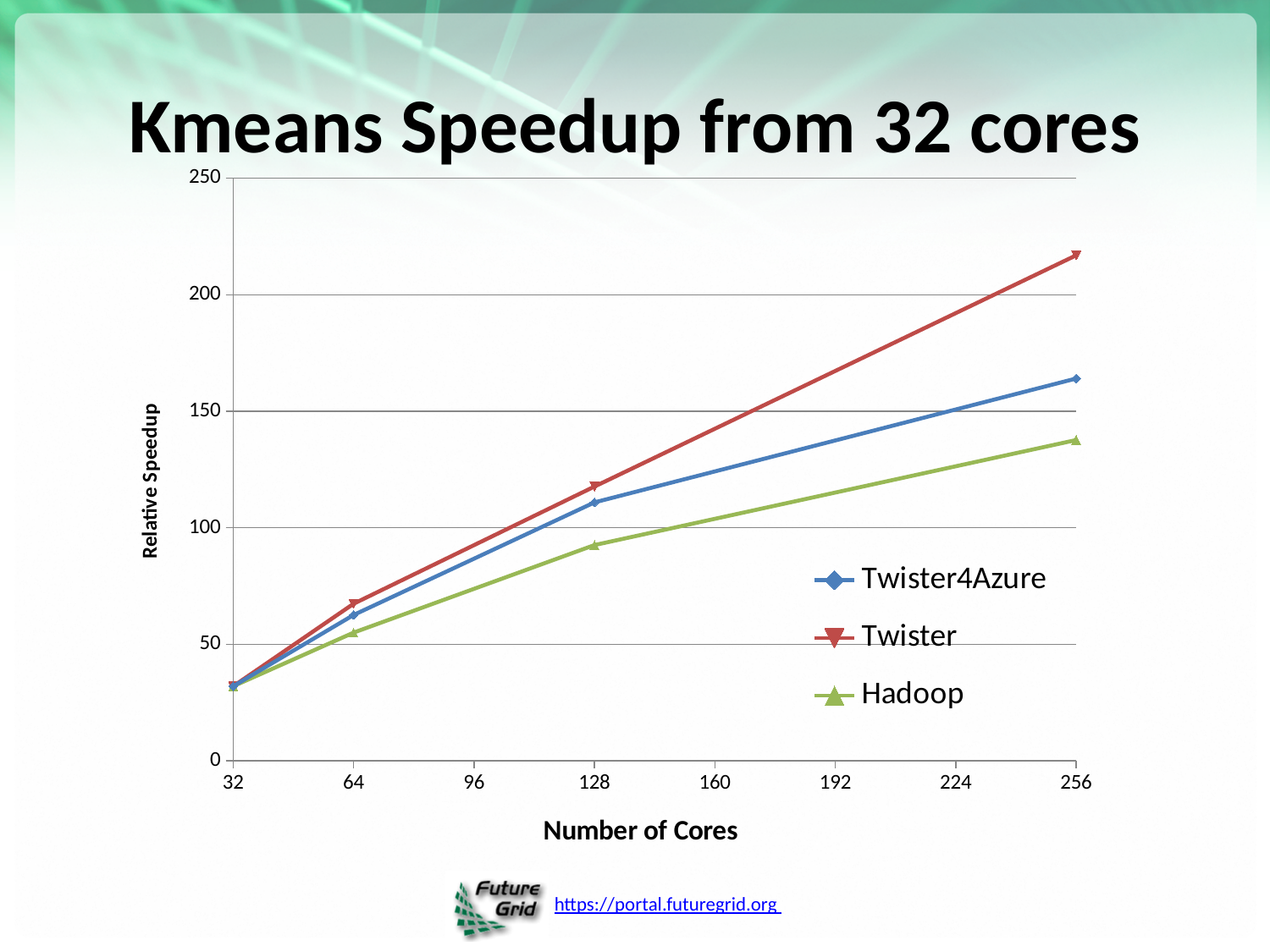
What kind of chart is shown on the slide? line chart Is the relative speedup for Twister at 128 cores greater or less than 100? greater What is the title of the chart? Kmeans Speedup from 32 cores At 256 cores, which has the larger relative speedup, Twister4Azure or Hadoop? Twister4Azure Do the relative speedup values rise or fall as the number of cores increases? rise Is the relative speedup for Twister at 256 cores greater or less than 200? greater Which series has the highest relative speedup at 256 cores? Twister Which series has the lowest relative speedup at 256 cores? Hadoop Is the relative speedup for Hadoop at 256 cores greater or less than 150? less What is the label of the y axis? Relative Speedup How many series does the legend list? 3